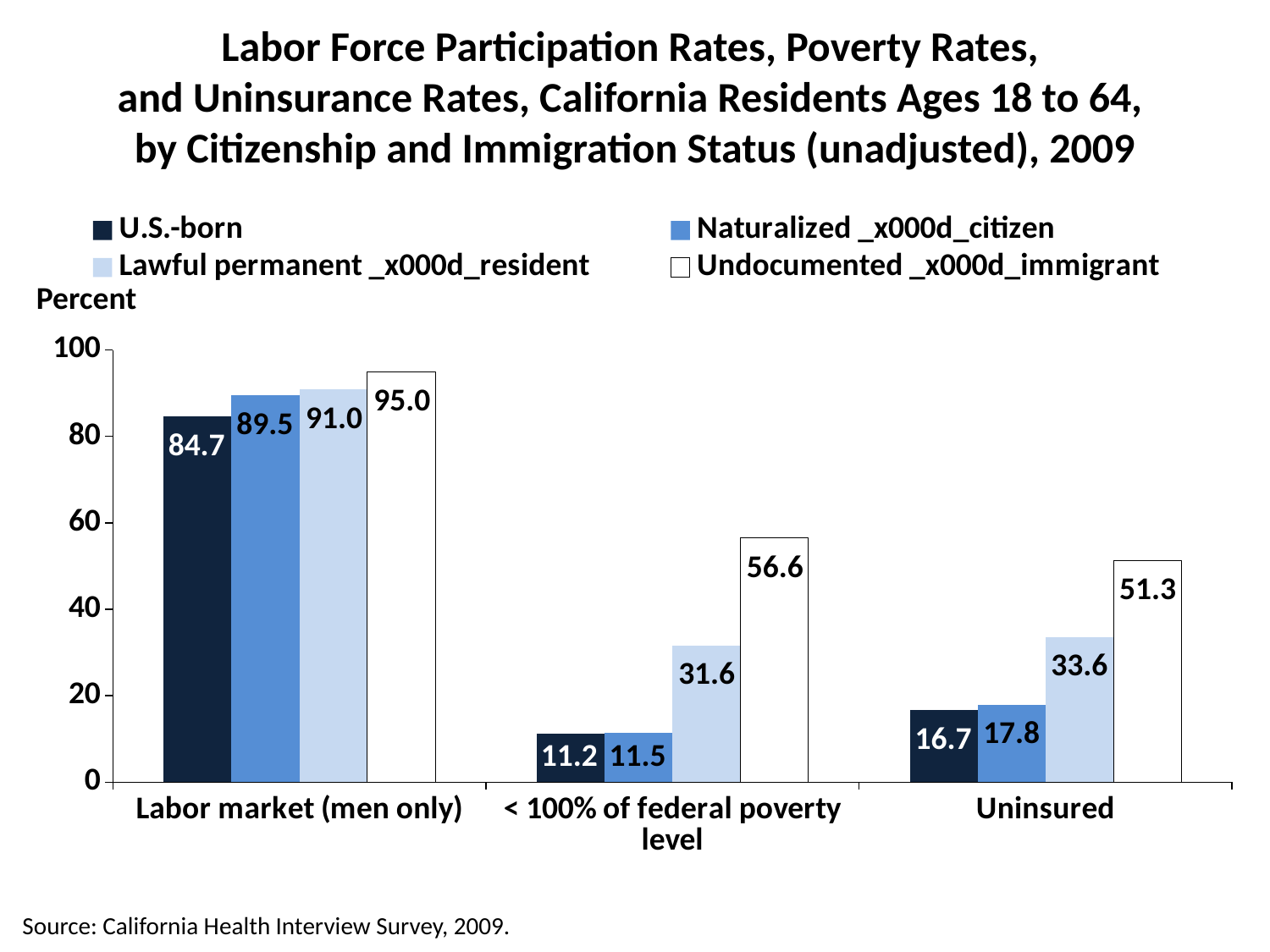
Which is larger: the Naturalized citizen value for Uninsured or the Naturalized citizen value for < 100% of federal poverty level? Uninsured Which group has the lowest value in the < 100% of federal poverty level category? U.S.-born What is the difference between the Undocumented immigrant and U.S.-born values in the Labor market (men only) category? 10.3 What is the value for U.S.-born residents in the Labor market (men only) category? 84.7 Which group has the highest value in the Uninsured category? Undocumented immigrant Is the value for Lawful permanent residents in the < 100% of federal poverty level category greater or less than 40? less What is the value for Lawful permanent residents in the Uninsured category? 33.6 What is the difference between the Undocumented immigrant and Lawful permanent resident values in the Uninsured category? 17.7 How many series does the legend list? 4 What is the value for Undocumented immigrants in the < 100% of federal poverty level category? 56.6 What kind of chart is shown on the slide? Bar chart How many categories are shown on the x axis? 3